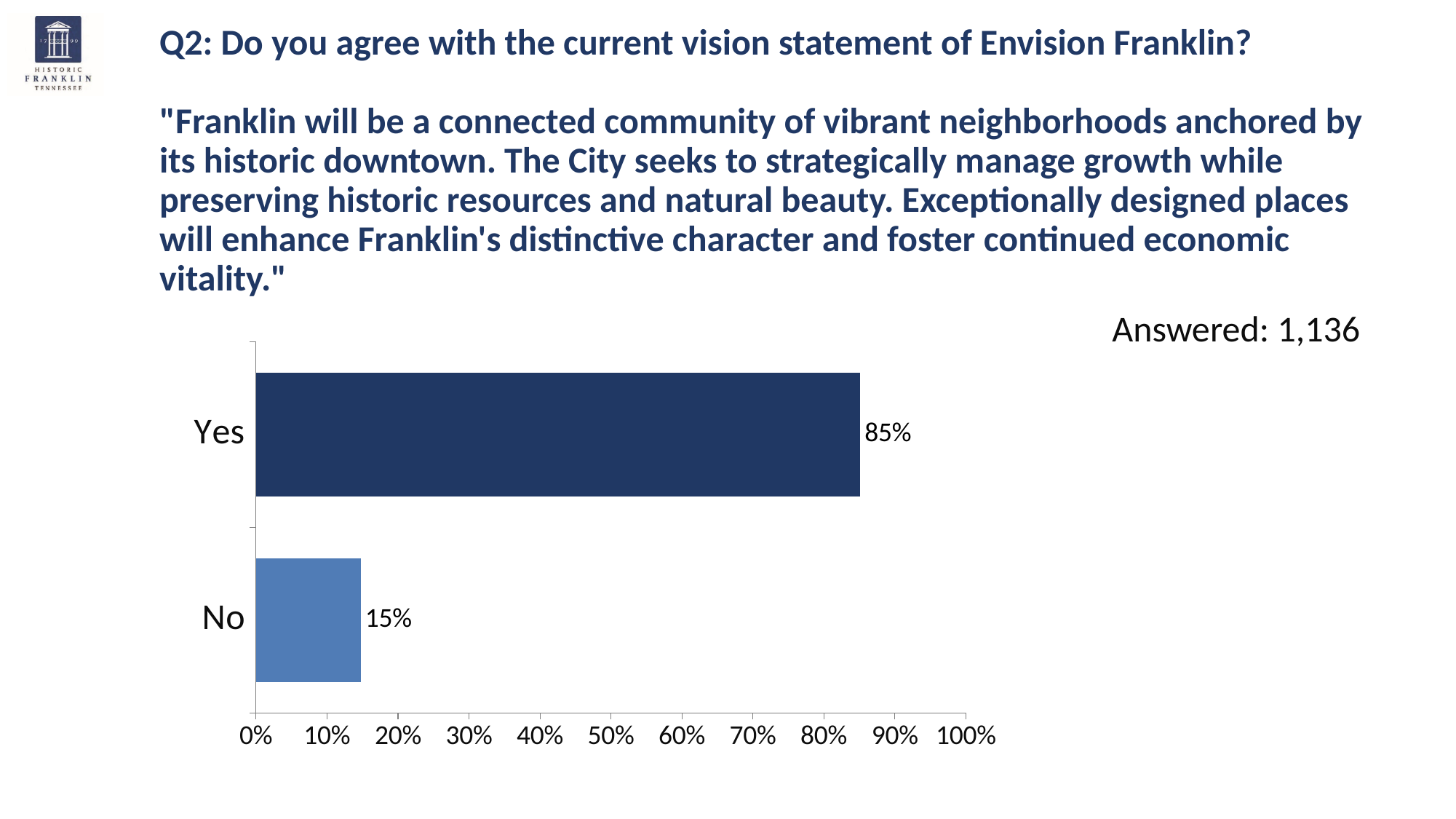
Which response is larger, Yes or No? Yes Which response has the lowest percentage? No Which response has the highest percentage? Yes Is the value for Yes greater or less than 80%? greater What kind of chart is shown on the slide? Bar chart What is the highest value shown on the horizontal axis? 100% What is the difference in percentage points between the Yes and No responses? 70 percentage points Is the value for No greater or less than 20%? less How many people answered this question, according to the slide? 1,136 How many response categories are shown in the chart? 2 What percentage of respondents answered No? 15% What percentage of respondents answered Yes? 85%